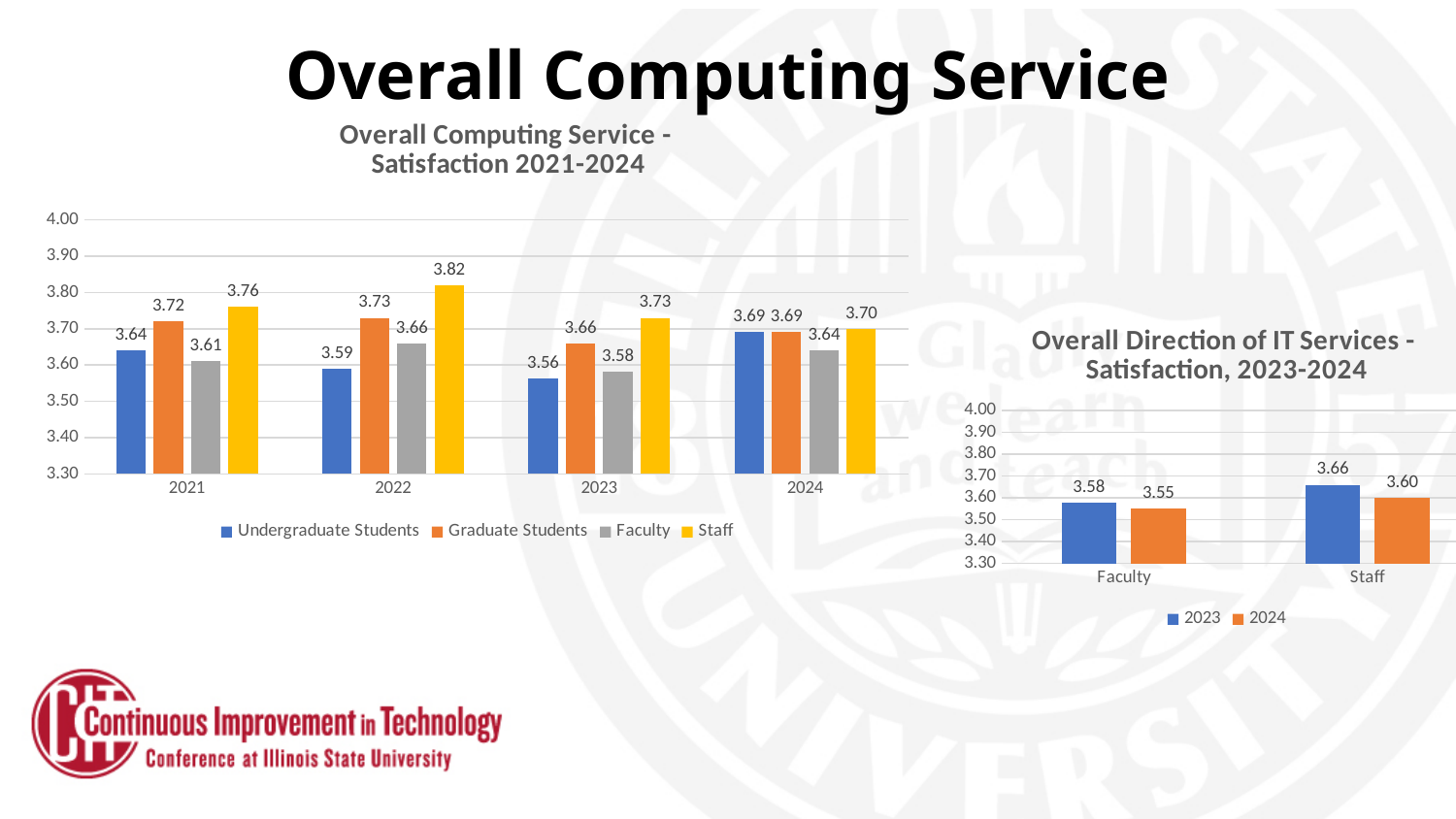
In the 'Overall Computing Service - Satisfaction 2021-2024' chart, what is the value for Staff in 2022? 3.82 In the 'Overall Direction of IT Services - Satisfaction, 2023-2024' chart, which is larger: Faculty in 2023 or Faculty in 2024? Faculty in 2023 What kind of chart is the 'Overall Direction of IT Services - Satisfaction, 2023-2024' chart? bar chart In the 'Overall Direction of IT Services - Satisfaction, 2023-2024' chart, what is the difference between the Staff 2023 value and the Staff 2024 value? 0.06 In the 'Overall Computing Service - Satisfaction 2021-2024' chart, how many years are shown on the x axis? 4 In the 'Overall Computing Service - Satisfaction 2021-2024' chart, which series has the highest value in 2021? Staff In the 'Overall Computing Service - Satisfaction 2021-2024' chart, which series has the lowest value in 2022? Undergraduate Students In the 'Overall Computing Service - Satisfaction 2021-2024' chart, what is the difference between the Staff value and the Undergraduate Students value in 2022? 0.23 In the 'Overall Direction of IT Services - Satisfaction, 2023-2024' chart, what is the value for Staff in 2024? 3.60 In the 'Overall Computing Service - Satisfaction 2021-2024' chart, how many series does the legend list? 4 In the 'Overall Computing Service - Satisfaction 2021-2024' chart, does the Faculty value rise or fall from 2023 to 2024? rise In the 'Overall Computing Service - Satisfaction 2021-2024' chart, what is the value for Undergraduate Students in 2023? 3.56